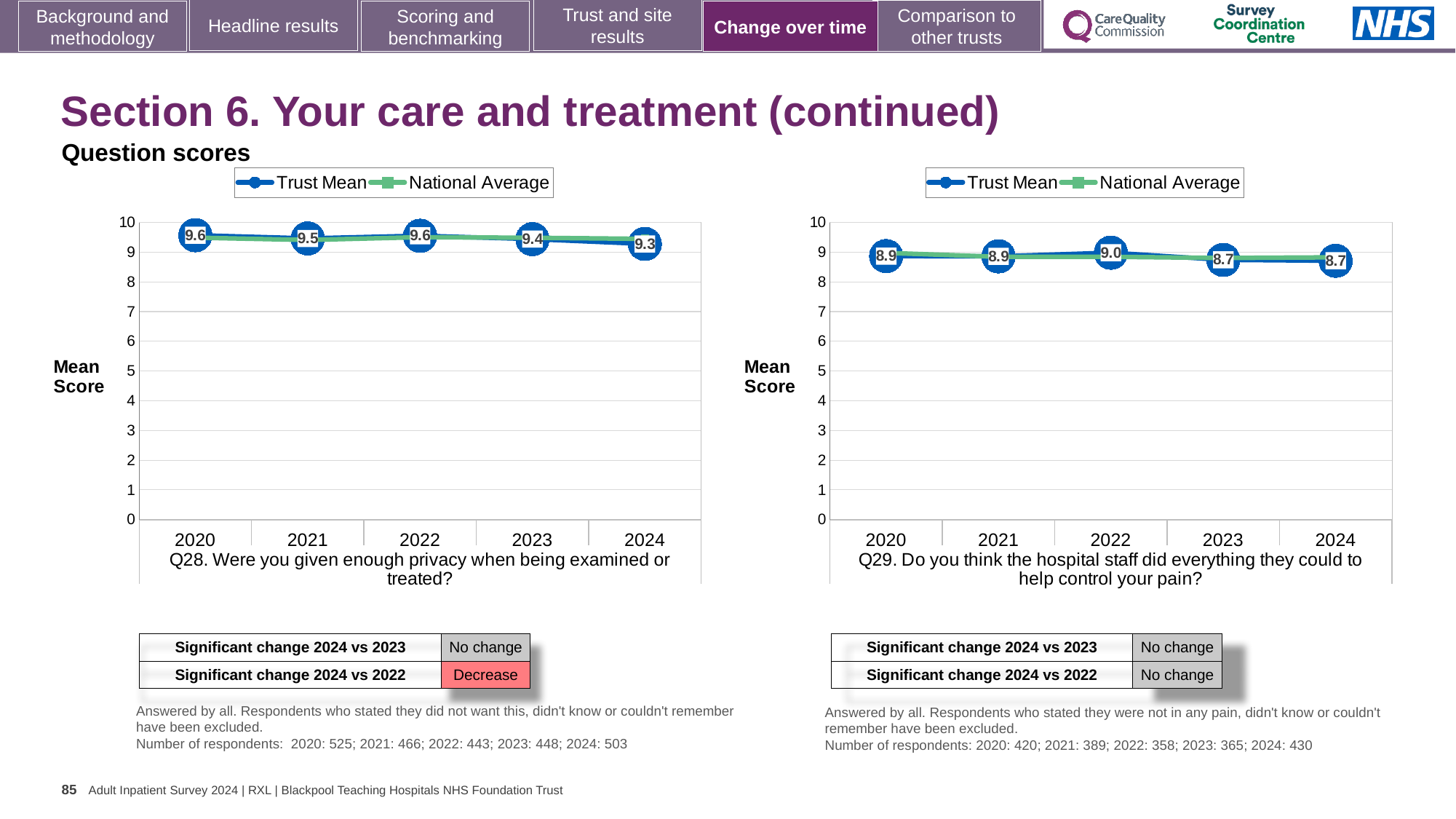
In the Q29 chart (right), is the National Average value for 2024 greater or less than 8? greater How many series does the legend of the Q29 chart (right) list? 2 In the Q28 chart (left), is the Trust Mean score higher in 2021 or in 2023? 2021 In the Q28 chart (left), does the Trust Mean score rise or fall overall from 2020 to 2024? Fall In the Q28 chart (left), what is the difference between the Trust Mean scores for 2020 and 2024? 0.3 In the Q29 chart (right), what is the Trust Mean score for 2022? 9.0 In the Q29 chart (right), which year has the highest Trust Mean score? 2022 In the Q28 chart (left), what is the Trust Mean score for 2024? 9.3 How many years are plotted on the x axis of the Q28 chart (left)? 5 In the Q29 chart (right), what is the difference between the Trust Mean scores for 2022 and 2024? 0.3 In the Q28 chart (left), which year has the lowest Trust Mean score? 2024 What kind of chart is the Q28 chart (left)? Line chart